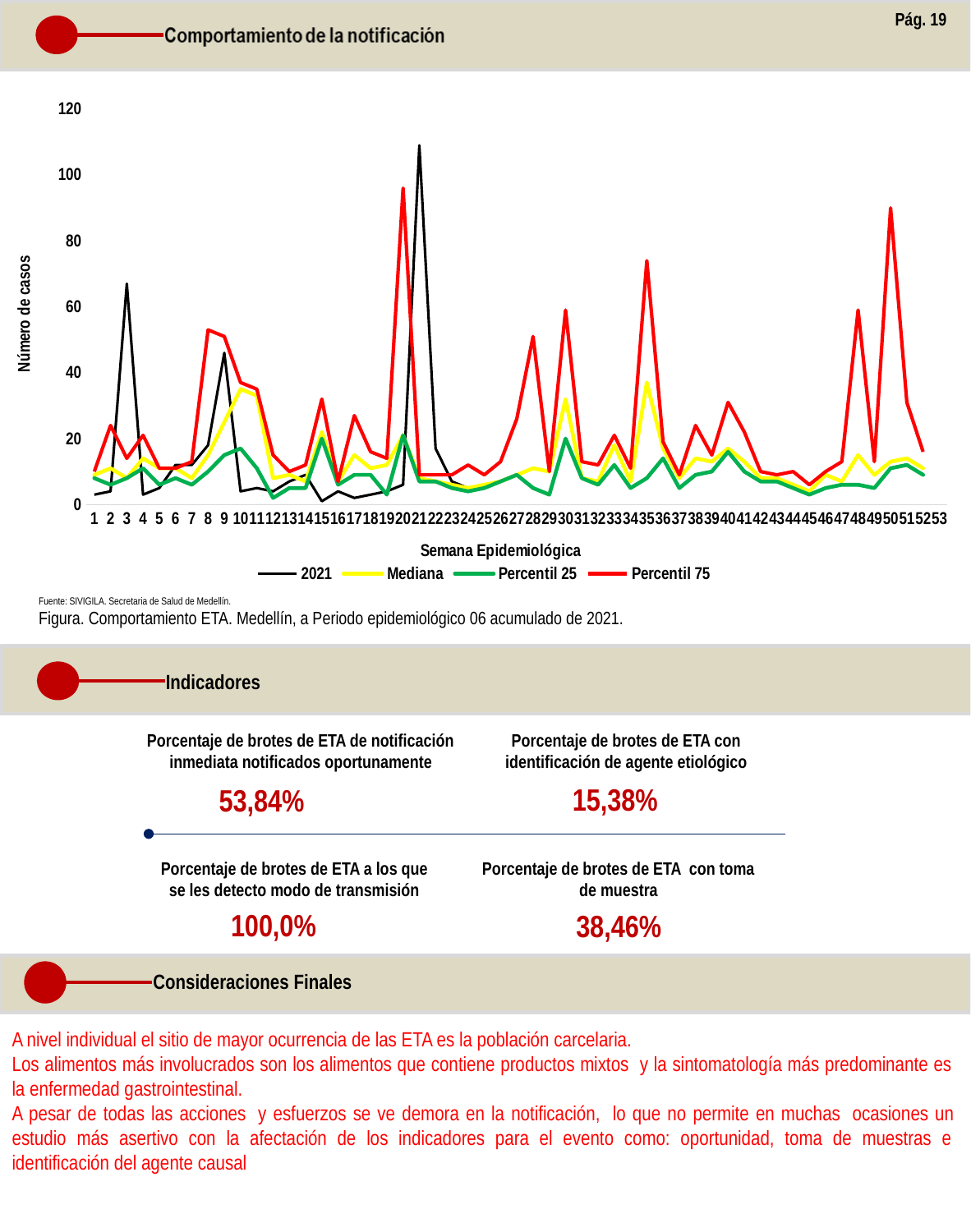
Is the value of the 2021 series in week 3 greater or less than 60? greater What is the title of the y axis of the line chart? Número de casos What kind of chart is shown under 'Comportamiento de la notificación'? line chart What colour is the Percentil 25 series in the line chart? green Which series in the line chart reaches the highest value on the chart? 2021 Is the value of the Percentil 75 series in week 20 greater or less than 80? greater In which epidemiological week does the 2021 series reach its highest value? 21 Is the value of the Mediana series in week 35 greater or less than 40? less How many series does the legend of the line chart list? 4 How many epidemiological weeks are shown on the x axis of the line chart? 53 In week 3, which series has the larger value, 2021 or Percentil 75? 2021